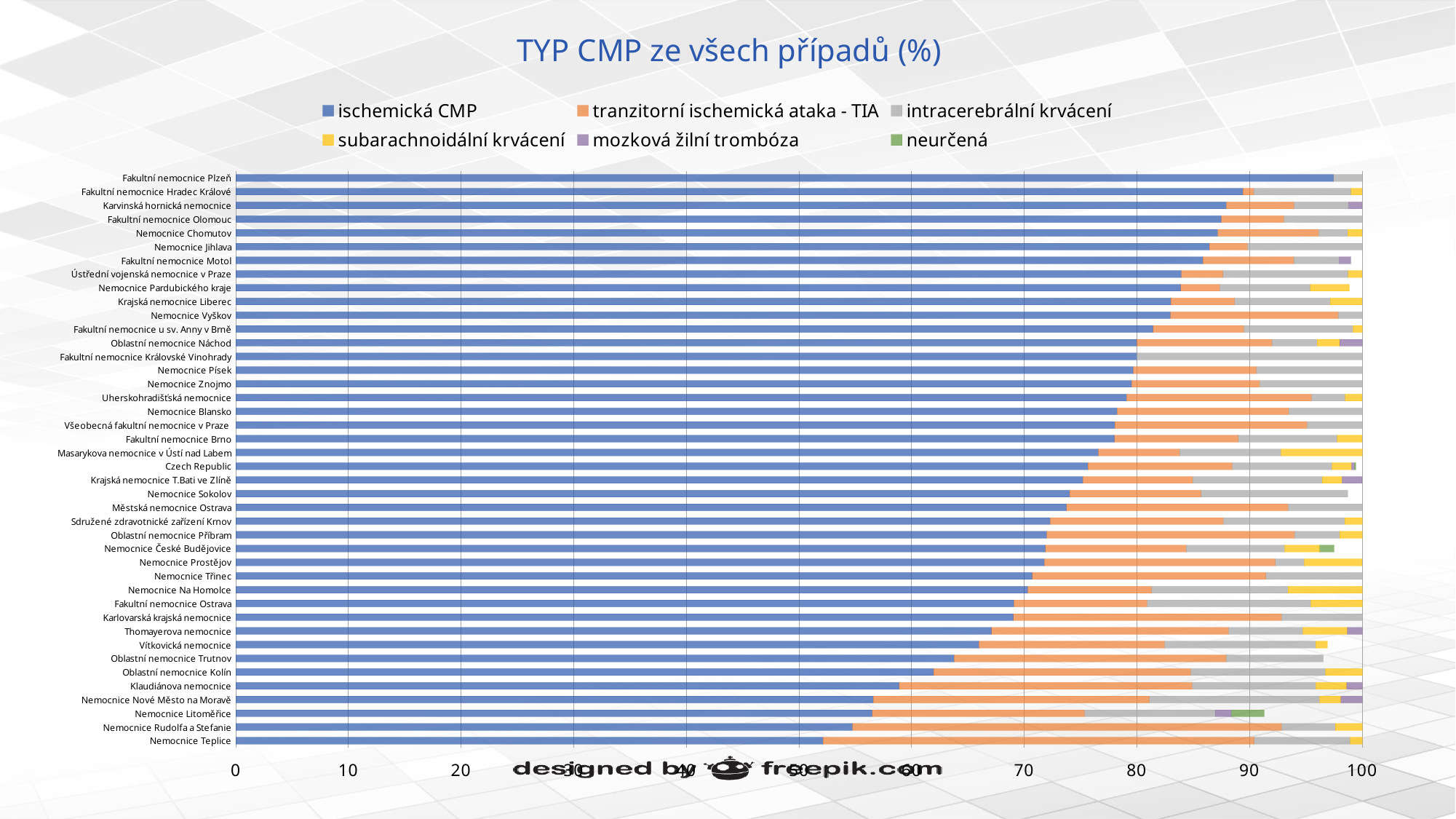
Going down the chart from top to bottom, do the ischemická CMP values increase or decrease? decrease How many series does the legend list? 6 Is the ischemická CMP value for Czech Republic greater or less than 70? greater How many hospitals (categories) are plotted on the chart? 42 Which has a larger ischemická CMP share, Nemocnice Jihlava or Nemocnice Třinec? Nemocnice Jihlava Is the ischemická CMP value for Fakultní nemocnice Plzeň greater or less than 90? greater Which hospital has the highest share of ischemická CMP? Fakultní nemocnice Plzeň Is the ischemická CMP value for Nemocnice Chomutov greater or less than 80? greater What is the title of the chart? TYP CMP ze všech případů (%) Which hospital has the lowest share of ischemická CMP? Nemocnice Teplice What kind of chart is shown on the slide? Stacked bar chart